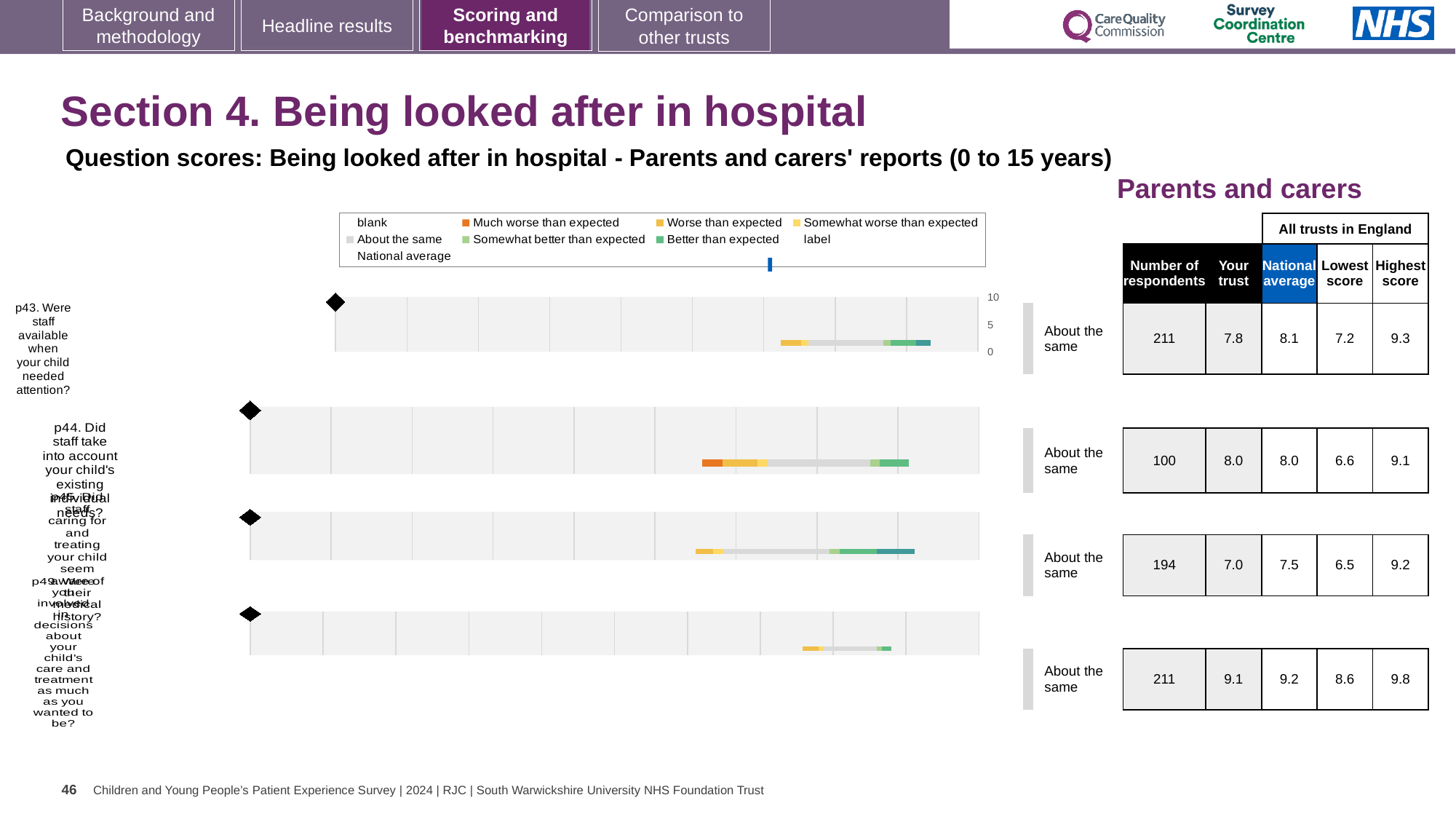
What benchmark category is shown next to each of the four charts? About the same What is the highest score among all trusts in England for the third chart from the top (p45)? 9.2 What is the national average score for p43 (Were staff available when your child needed attention?)? 8.1 Which of the four questions on the slide has the highest 'Your trust' score? p49 (bottom chart), 9.1 Which of the four questions on the slide has the lowest 'Your trust' score? p45 (third chart), 7.0 How many question charts are shown on the slide? 4 What kind of chart is used for each question on the slide? Bar chart Which has the larger 'Your trust' score: p43 or p44? p44 For the third chart from the top (p45), what is the difference between the national average and the 'Your trust' score? 0.5 How many respondents are shown for p44 (Did staff take into account your child's existing individual needs?)? 100 What is the 'Your trust' score for p43 (Were staff available when your child needed attention?)? 7.8 What is the lowest score among all trusts in England for the bottom chart (p49)? 8.6